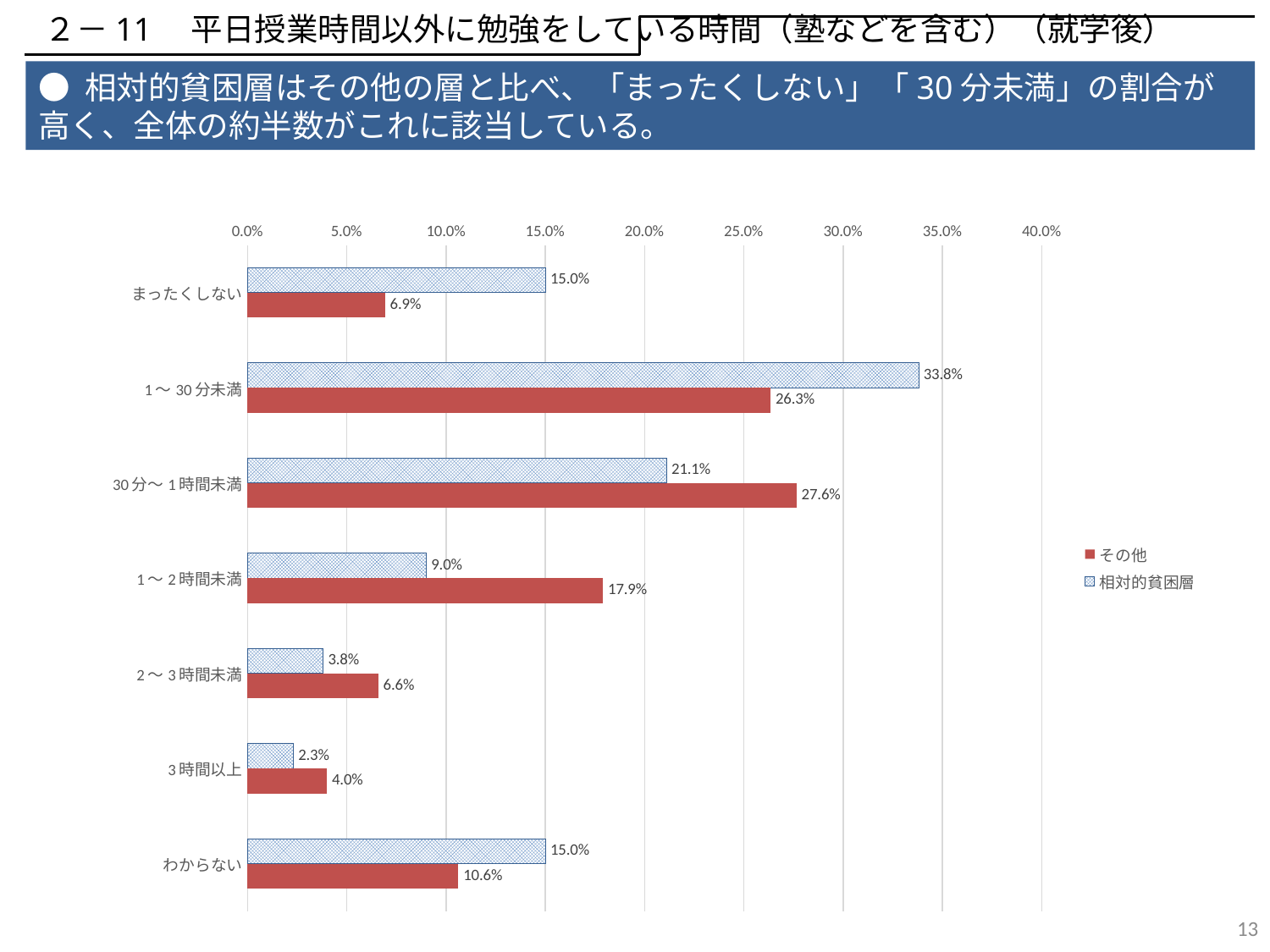
What is the value for 相対的貧困層 in the まったくしない category? 15.0% What is the difference between その他 and 相対的貧困層 in the わからない category? 4.4% How many categories are shown on the chart? 7 What is the value for その他 in the 30分～1時間未満 category? 27.6% Which category has the lowest value for その他? 3時間以上 Which series is shown with a red solid fill in the legend? その他 How many series does the legend list? 2 What is the difference between 相対的貧困層 and その他 in the 1～30分未満 category? 7.5% In the 1～2時間未満 category, which series has the larger value, その他 or 相対的貧困層? その他 What is the value for その他 in the 3時間以上 category? 4.0% Which category has the highest value for 相対的貧困層? 1～30分未満 What kind of chart is shown on the slide? Bar chart